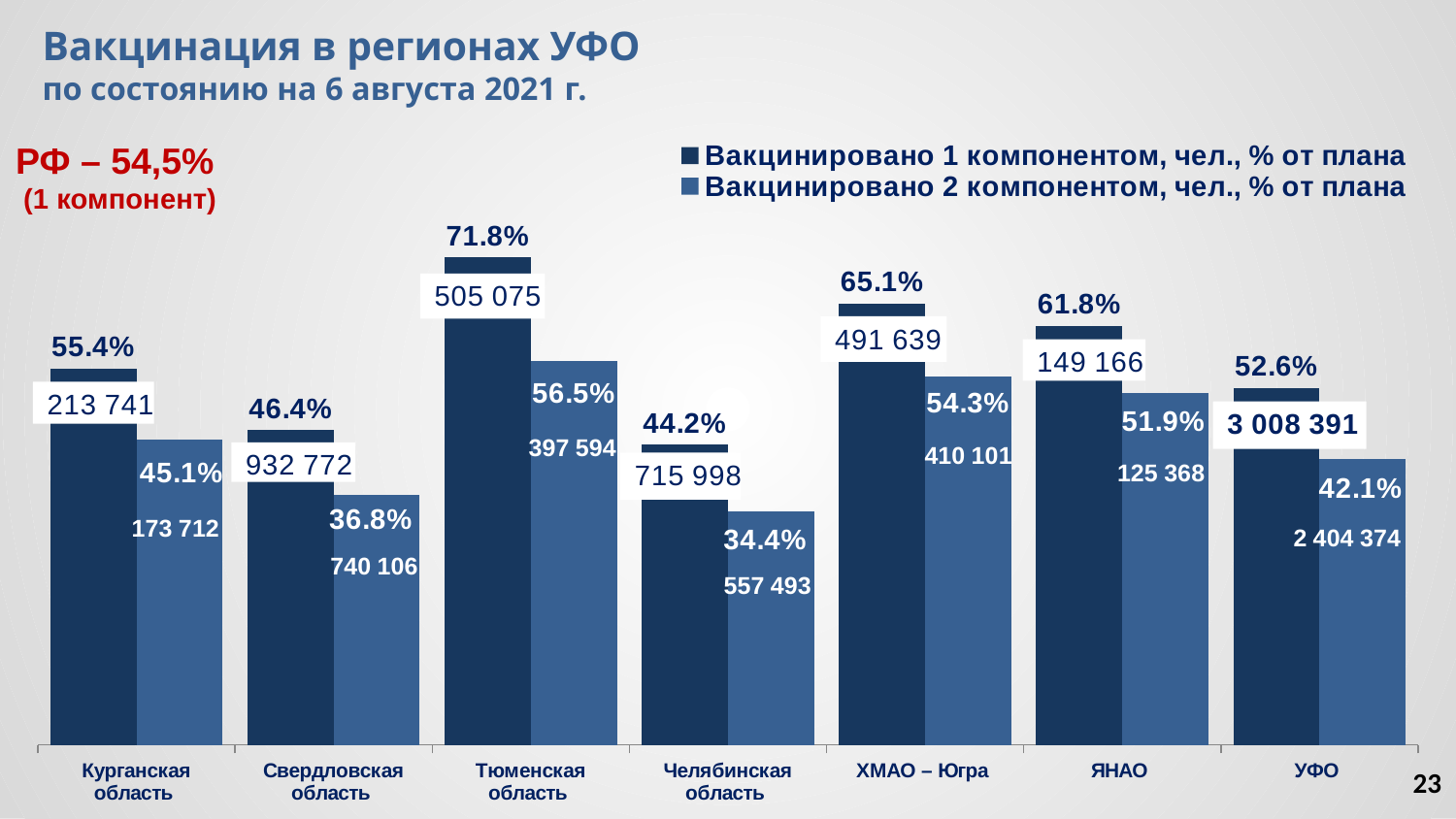
Which region has the lowest percentage vaccinated with 2 components? Челябинская область What percentage of the plan is shown for vaccination with 2 components in ХМАО – Югра? 54.3% Which is larger: the 1-component percentage for Курганская область or for Свердловская область? Курганская область How many series does the chart legend list? 2 How many people are shown as vaccinated with 1 component in УФО? 3 008 391 What is the value for the Russian Federation (РФ) for 1 component shown in red on the slide? 54,5% Which region has the highest percentage vaccinated with 1 component? Тюменская область How many people are shown as vaccinated with 2 components in Свердловская область? 740 106 How many categories are shown on the x axis of the chart? 7 What percentage of the plan is shown for vaccination with 1 component in Тюменская область? 71.8% What type of chart is shown on the slide? Bar chart What is the difference in percentage points between the 1-component and 2-component values for ЯНАО? 9.9